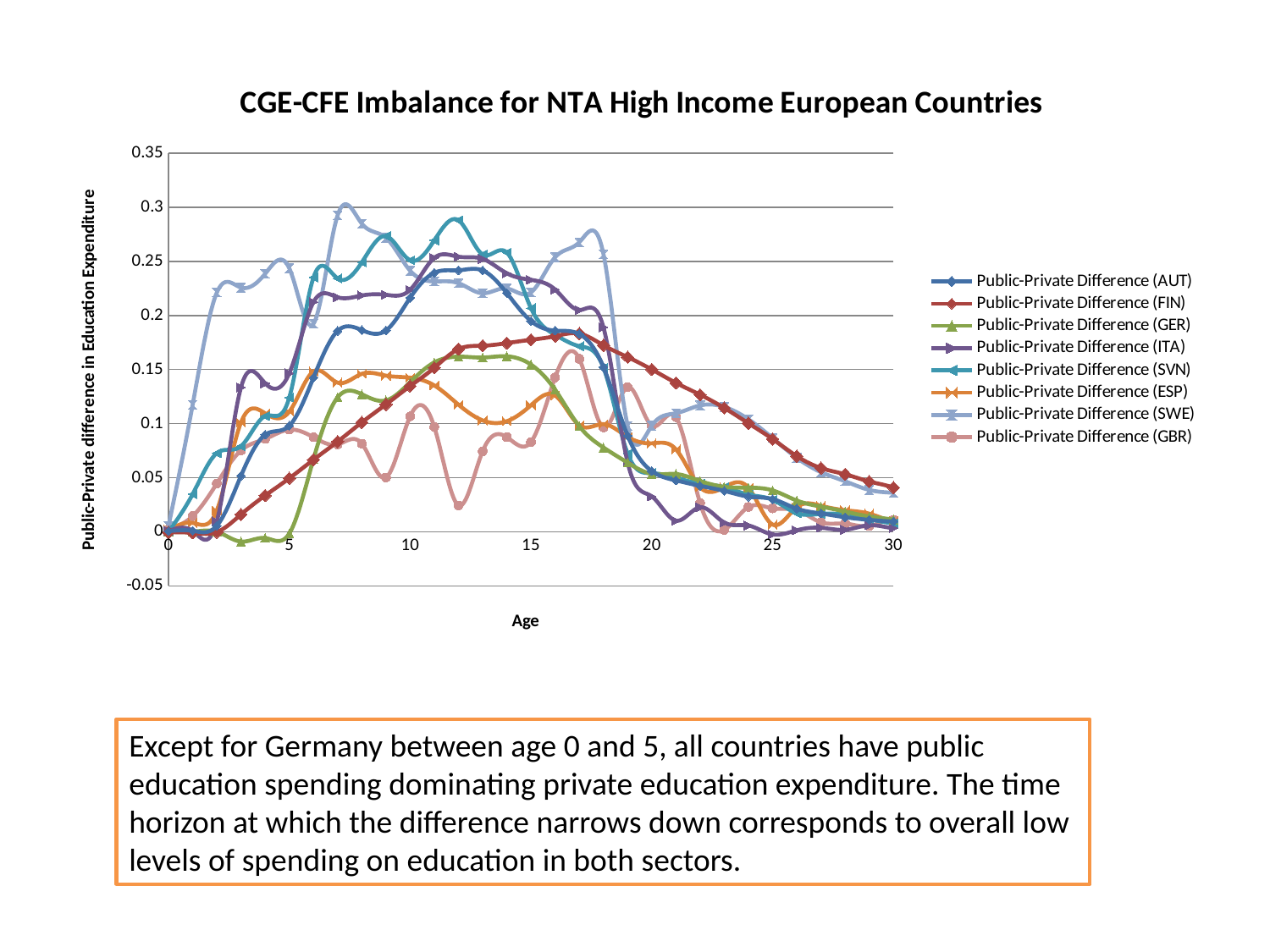
Is the value for Public-Private Difference (SWE) at age 7 greater or less than 0.25? greater Is the value for Public-Private Difference (SVN) at age 12 greater or less than 0.25? greater Is the value for Public-Private Difference (FIN) at age 30 greater or less than 0.05? less What is the title of the chart? CGE-CFE Imbalance for NTA High Income European Countries At age 20, which is larger: Public-Private Difference (FIN) or Public-Private Difference (ITA)? Public-Private Difference (FIN) How many series does the legend list? 8 Which series has the lowest value at age 3? Public-Private Difference (GER) Which series has the highest value at age 1? Public-Private Difference (SWE) What kind of chart is shown on the slide? line chart What is the label of the x axis? Age Does the Public-Private Difference (FIN) series rise or fall between age 17 and age 30? fall